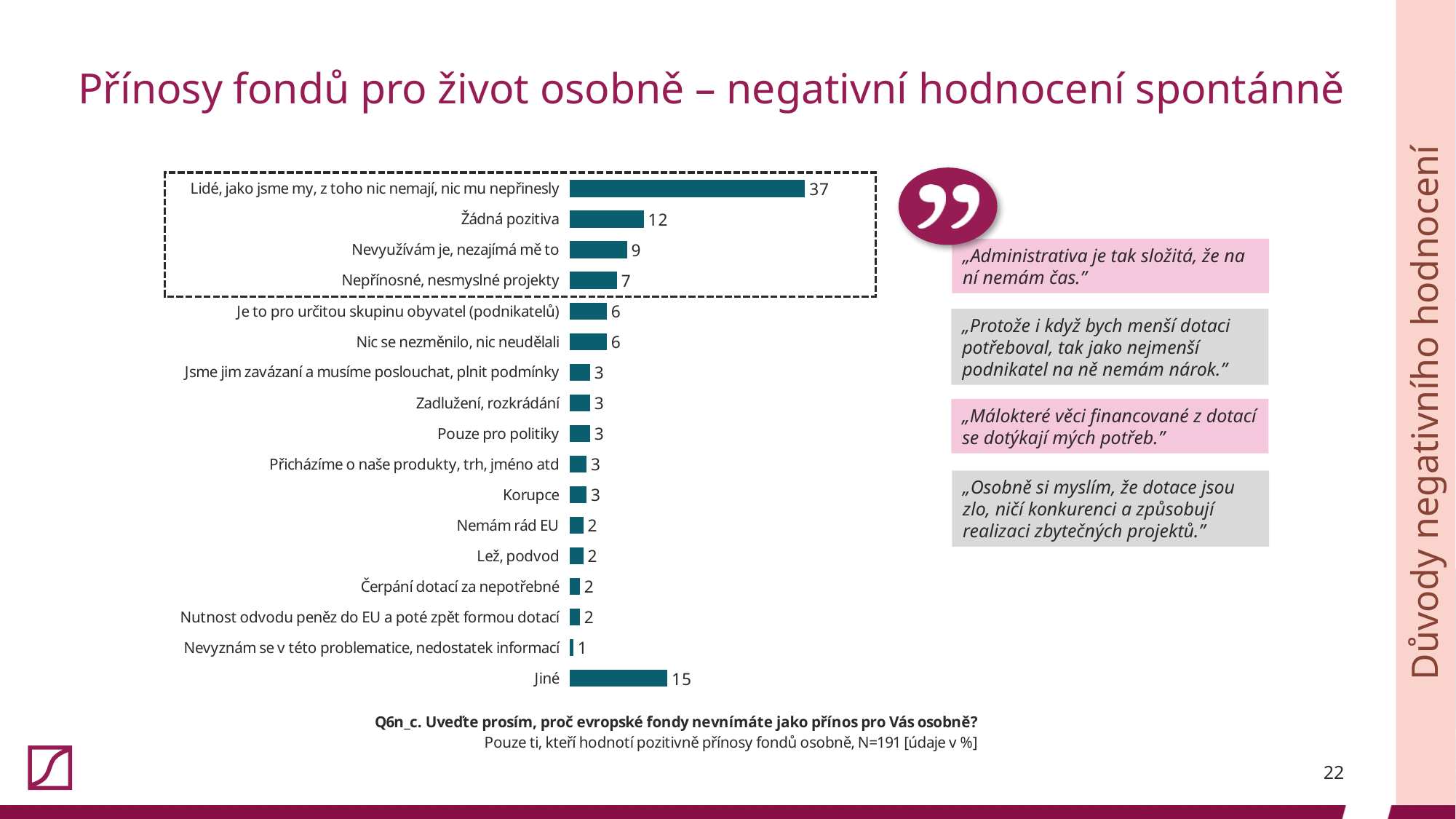
What value is shown for "Žádná pozitiva"? 12 What is the difference between the values for "Lidé, jako jsme my, z toho nic nemají, nic mu nepřinesly" and "Žádná pozitiva"? 25 What is the difference between the values for "Jiné" and "Nepřínosné, nesmyslné projekty"? 8 What value is shown for "Nevyužívám je, nezajímá mě to"? 9 What value is shown for "Korupce"? 3 Which category has the highest value? Lidé, jako jsme my, z toho nic nemají, nic mu nepřinesly Which is larger, the value for "Jiné" or the value for "Žádná pozitiva"? Jiné How many categories are shown in the chart? 17 How many categories are enclosed by the dashed box at the top of the chart? 4 Which category has the lowest value? Nevyznám se v této problematice, nedostatek informací What kind of chart is shown on the slide? Bar chart What value is shown for "Jiné"? 15